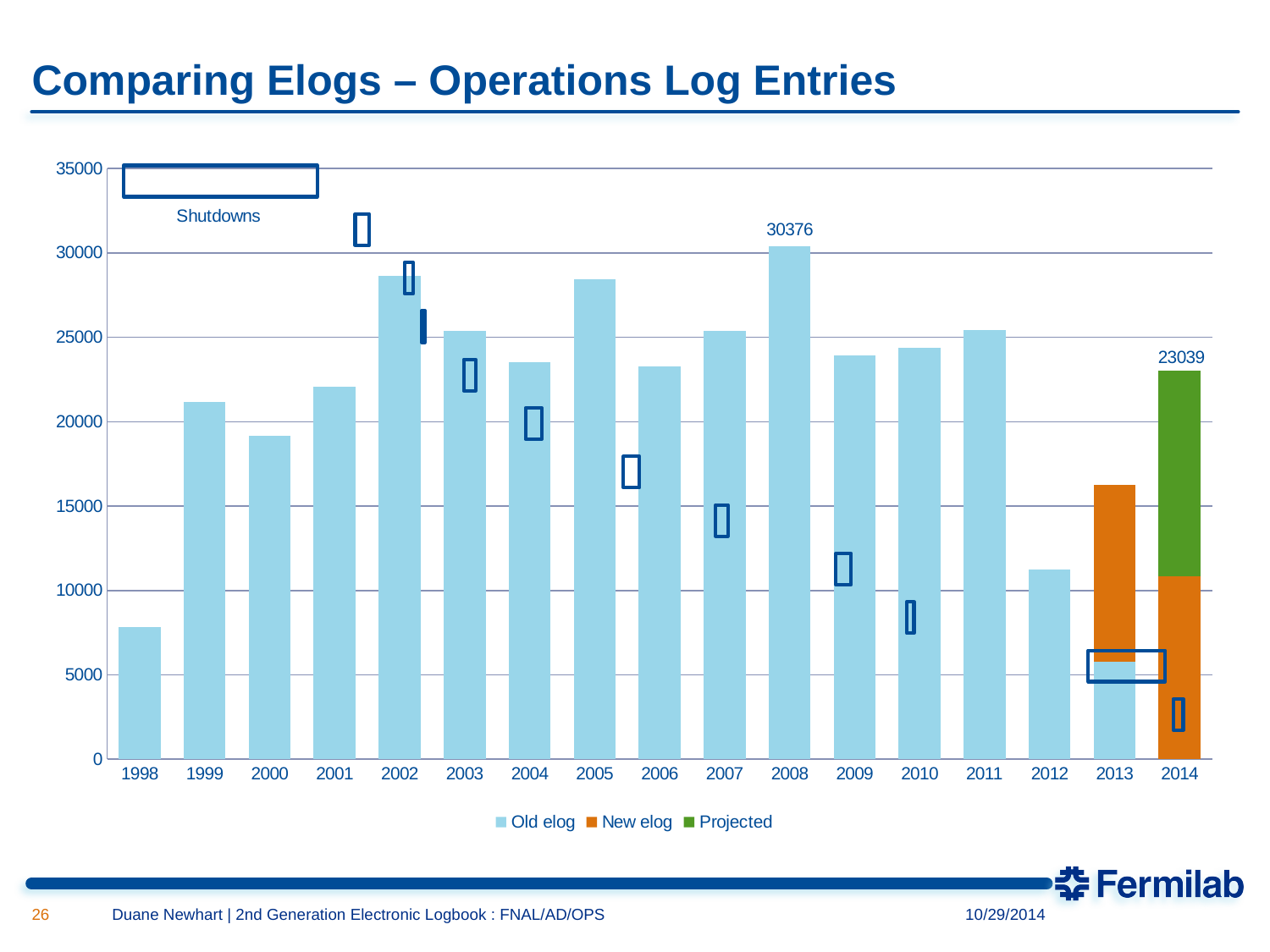
Do the values rise or fall from 2008 to 2012? fall Which series is shown in green in the legend? Projected What is the total labelled on the stacked bar for 2014? 23039 Is the value for 2012 greater or less than 15000? less What is the value labelled on the bar for 2008? 30376 What kind of chart is shown on the slide? bar chart How many series does the legend list? 3 Is the value for 2002 greater or less than 25000? greater Which year has the lowest number of operations log entries? 1998 Which year has the highest number of operations log entries? 2008 How many years are shown on the x axis? 17 Which year has the larger value, 2005 or 2006? 2005